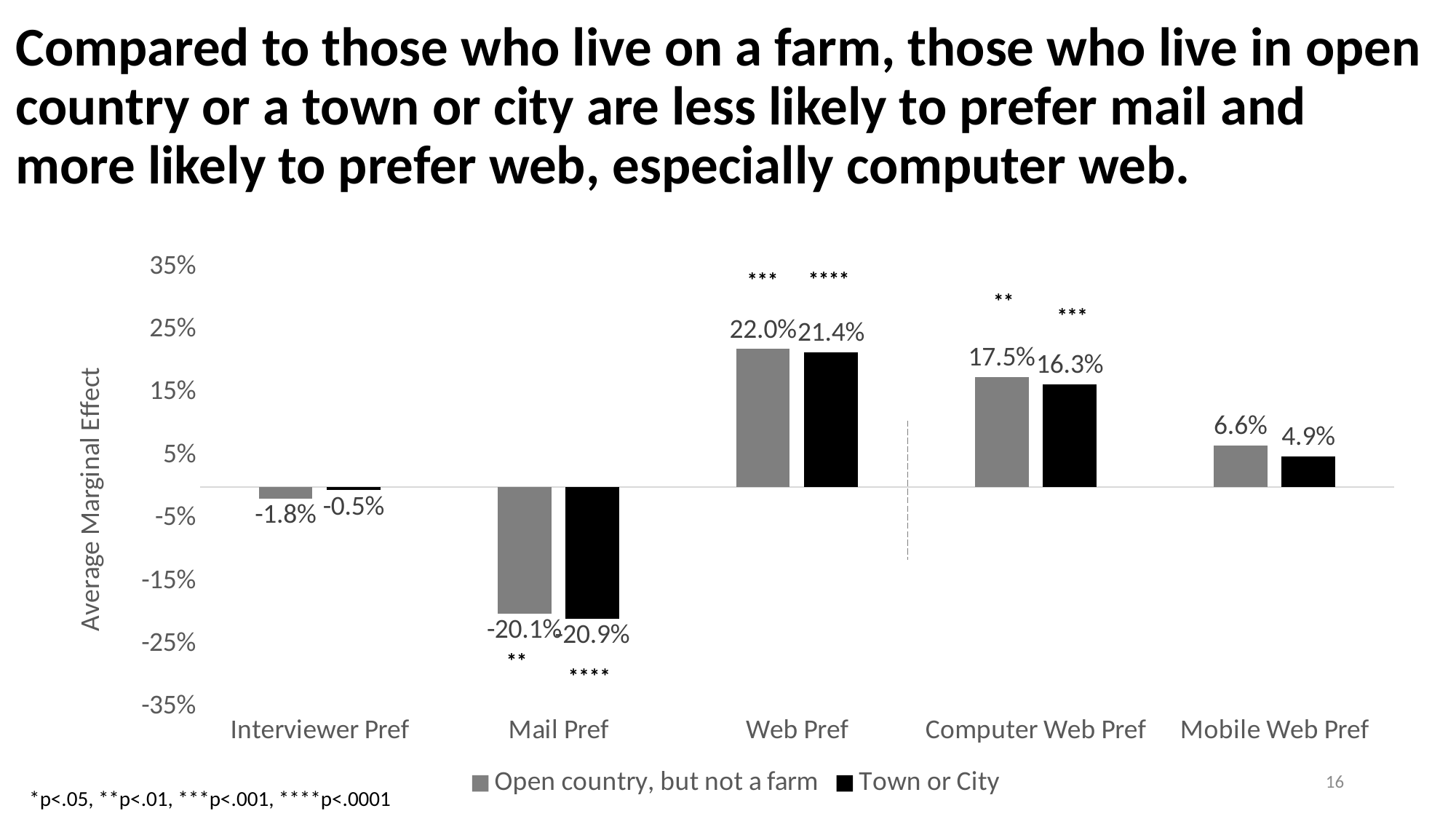
What is the difference between the Open country, but not a farm and Town or City values for Computer Web Pref? 1.2% How many series does the legend list? 2 What is the value for Interviewer Pref for the Open country, but not a farm series? -1.8% What kind of chart is shown on the slide? Bar chart For Mobile Web Pref, which series has the larger value: Open country, but not a farm or Town or City? Open country, but not a farm What is the value for Mobile Web Pref for the Town or City series? 4.9% What is the label of the vertical axis? Average Marginal Effect What is the average marginal effect for Web Pref for the Open country, but not a farm series? 22.0% How many categories are shown on the x axis? 5 Which category has the lowest value for the Open country, but not a farm series? Mail Pref What is the average marginal effect for Mail Pref for the Town or City series? -20.9% Which category has the highest value for the Town or City series? Web Pref